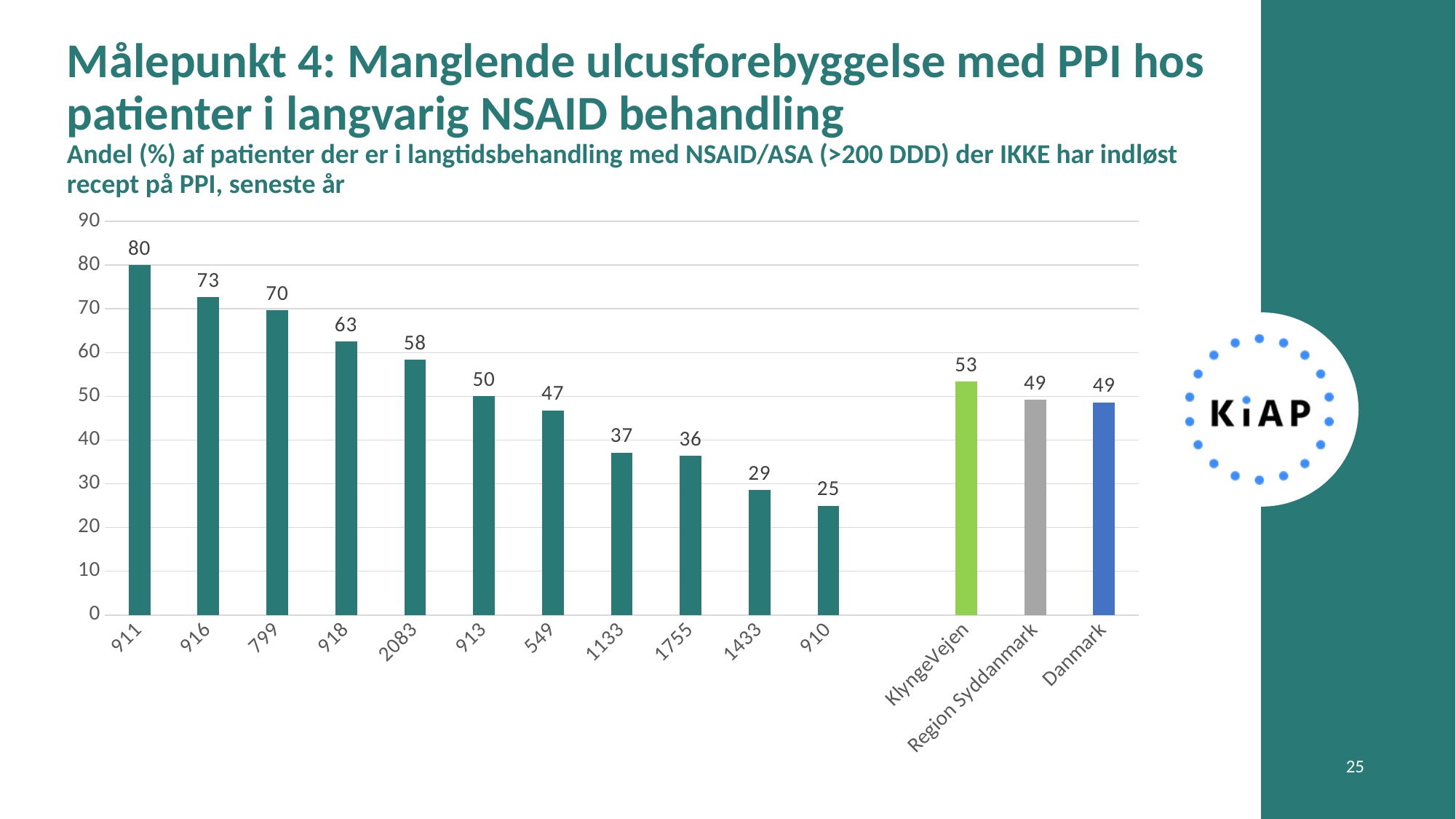
What is the difference between the values for 911 and 910? 55 What colour is the bar for Danmark? blue Is the value for 1133 greater or less than 40? less What is the value for Region Syddanmark? 49 Which category has the lowest value? 910 What is the difference between the values for KlyngeVejen and Danmark? 4 What kind of chart is shown on the slide? bar chart What is the value for category 911? 80 What is the value for KlyngeVejen? 53 Which is larger, the value for 2083 or the value for 913? 2083 How many bars are shown in the chart? 14 Which category has the highest value? 911